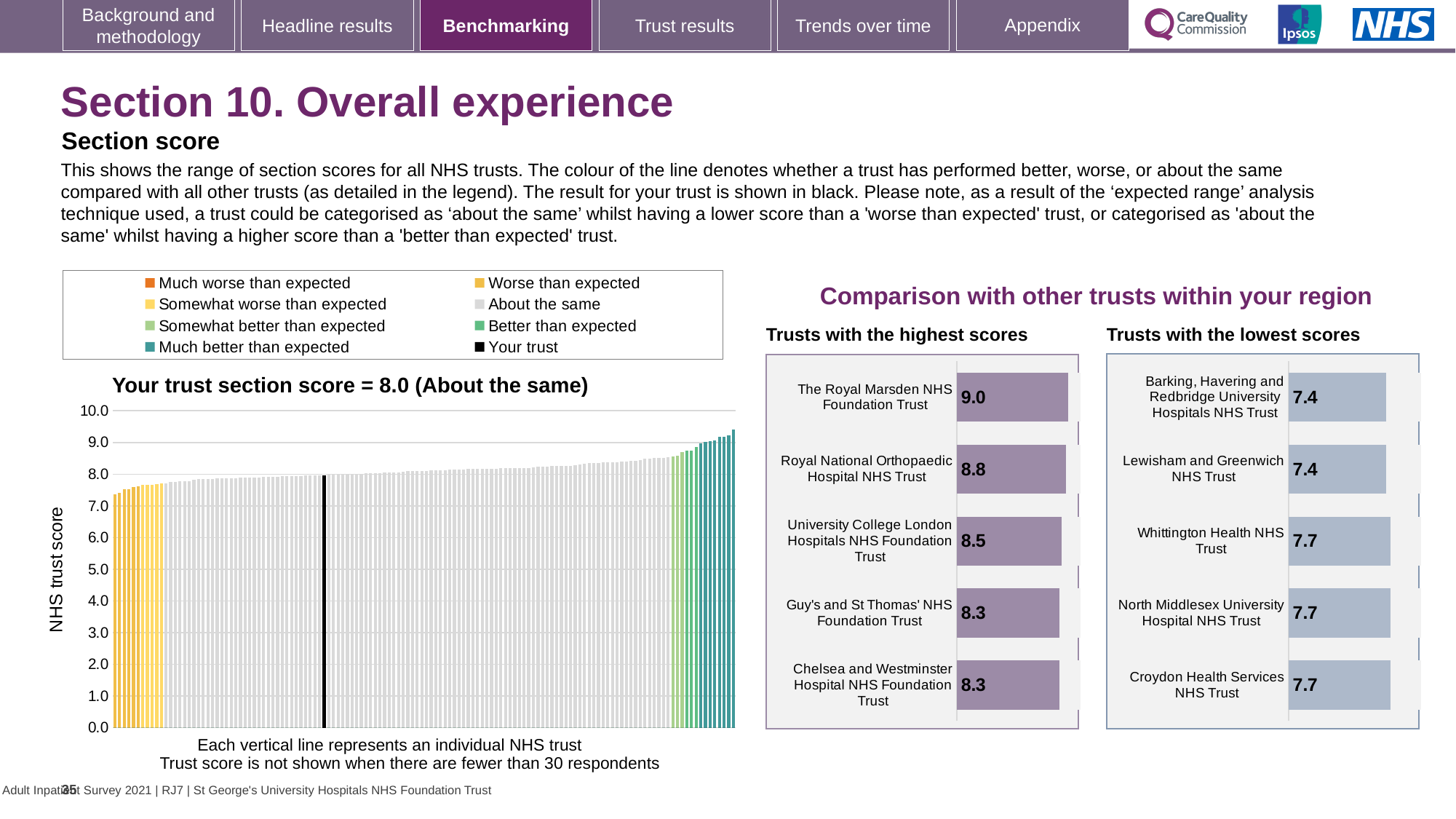
In the 'Trusts with the lowest scores' chart, what is the difference between the scores of Croydon Health Services NHS Trust and Barking, Havering and Redbridge University Hospitals NHS Trust? 0.3 In the 'Your trust section score' chart, is the value of the leftmost bar greater or less than 8.0? less What kind of chart is the 'Your trust section score' chart? bar chart In the 'Trusts with the highest scores' chart, what is the difference between the scores of The Royal Marsden NHS Foundation Trust and Royal National Orthopaedic Hospital NHS Trust? 0.2 In the 'Your trust section score' chart, do the trust scores rise or fall from left to right? rise In the 'Trusts with the lowest scores' chart, what is the score for Lewisham and Greenwich NHS Trust? 7.4 In the 'Trusts with the highest scores' chart, what is the score for The Royal Marsden NHS Foundation Trust? 9.0 How many trusts are shown in the 'Trusts with the lowest scores' chart? 5 How many entries does the legend above the 'Your trust section score' chart list? 8 In the 'Trusts with the highest scores' chart, which trust has the highest score? The Royal Marsden NHS Foundation Trust In the 'Your trust section score' chart, what is the section score for your trust? 8.0 In the 'Your trust section score' chart, which category is your trust placed in? About the same